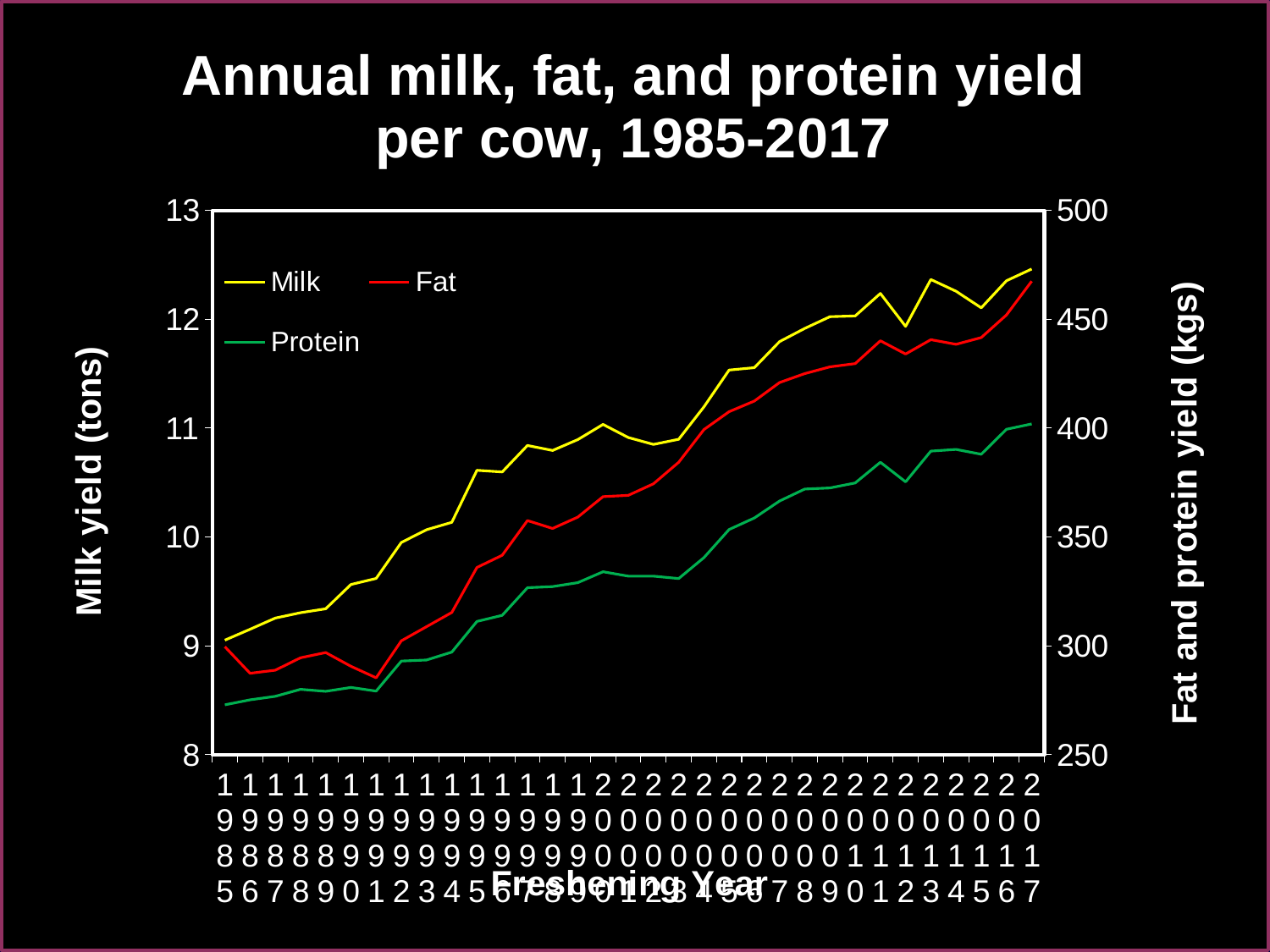
Is the Fat yield value for 1991 greater or less than 300? less Do the Milk yield values generally rise or fall from 1985 to 2017? rise Is the Protein yield value for 2017 greater or less than 350? greater How many freshening years are plotted along the x axis? 33 How many series does the legend list? 3 Which series are listed in the legend? Milk, Fat, Protein Is the Milk yield value for 2017 greater or less than 12? greater Which series has higher values throughout, Fat or Protein? Fat Which year has the lowest Milk yield? 1985 What is the label of the left vertical axis? Milk yield (tons) What kind of chart is shown on the slide? line chart